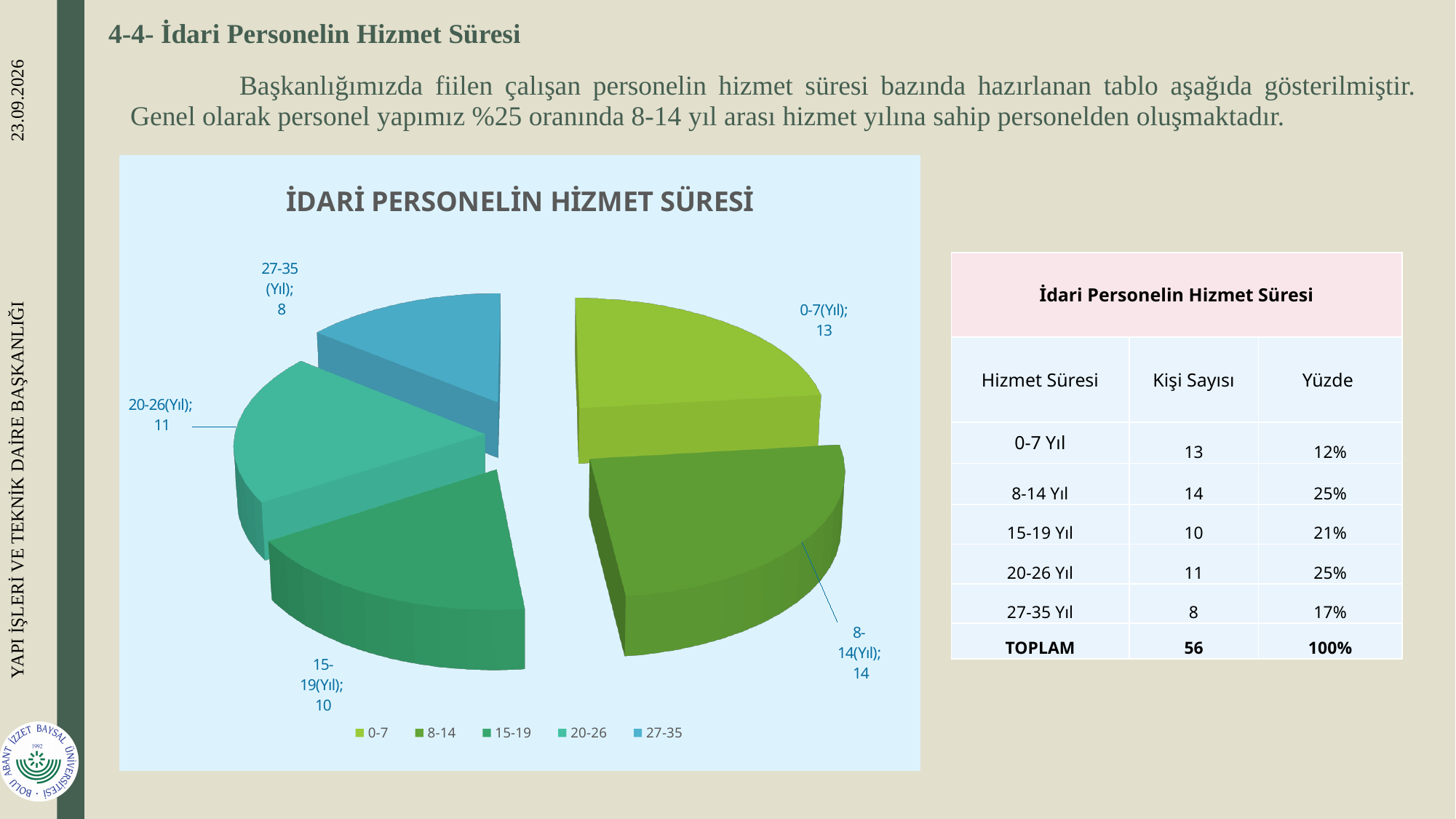
How many slices does the pie chart have? 5 What is the difference between the values for 20-26 (Yıl) and 15-19 (Yıl)? 1 What is the value for the 8-14 (Yıl) slice? 14 What is the value for the 0-7 (Yıl) slice? 13 What is the title of the chart? İDARİ PERSONELİN HİZMET SÜRESİ What is the total of all slice values in the pie chart? 56 Which category has the largest slice in the pie chart? 8-14 How many entries does the chart legend list? 5 What is the value for the 27-35 (Yıl) slice? 8 What type of chart is shown on the slide? pie chart Which category has the smallest slice in the pie chart? 27-35 Which is larger, the value for 0-7 (Yıl) or the value for 27-35 (Yıl)? 0-7 (Yıl)